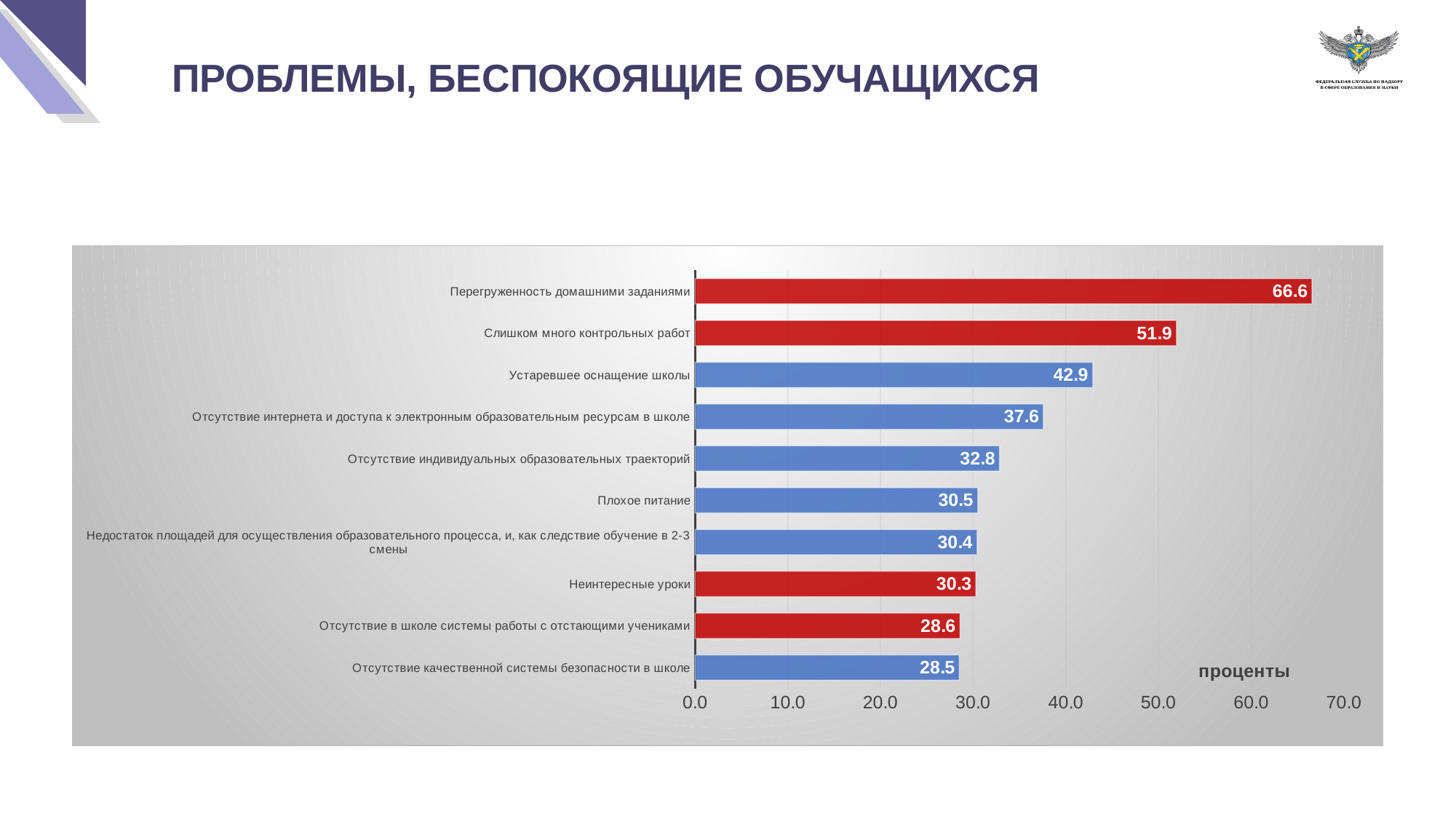
Is the value for "Слишком много контрольных работ" greater or less than 50.0? greater What type of chart is shown on the slide? Bar chart What is the difference between the values for "Перегруженность домашними заданиями" and "Слишком много контрольных работ"? 14.7 Which category has the lowest value? Отсутствие качественной системы безопасности в школе What is the value for "Устаревшее оснащение школы"? 42.9 What is the label shown on the horizontal axis of the chart? проценты How many categories are shown in the chart? 10 Which category has the highest value? Перегруженность домашними заданиями What is the value for "Отсутствие в школе системы работы с отстающими учениками"? 28.6 What is the value for "Перегруженность домашними заданиями"? 66.6 What is the value for "Плохое питание"? 30.5 Which is larger: the value for "Отсутствие интернета и доступа к электронным образовательным ресурсам в школе" or the value for "Отсутствие индивидуальных образовательных траекторий"? Отсутствие интернета и доступа к электронным образовательным ресурсам в школе